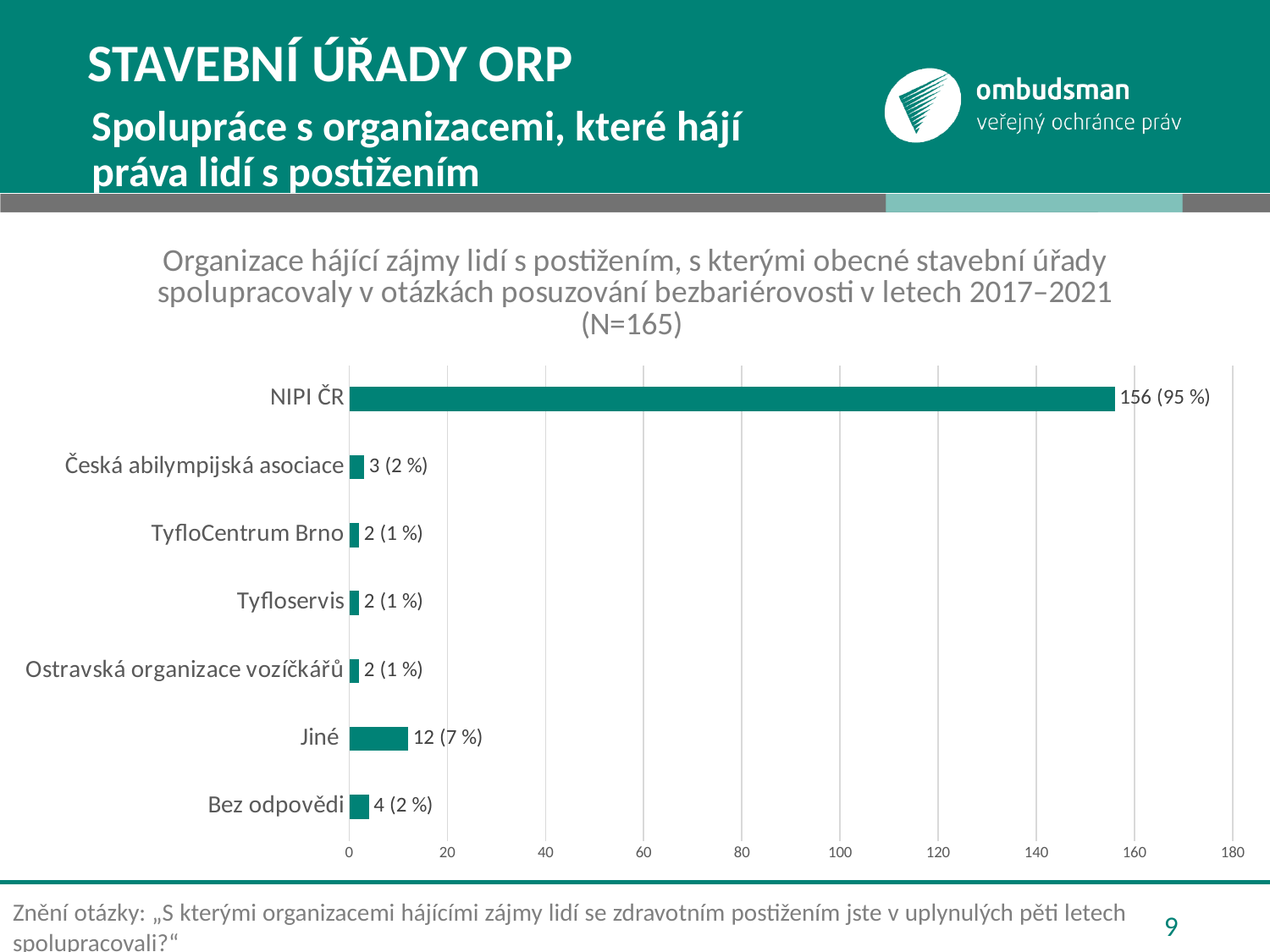
What is the N value stated in the chart title? 165 How many categories are shown on the chart? 7 What is the difference between the values for NIPI ČR and Jiné? 144 What is the value shown for Bez odpovědi? 4 (2 %) Which category has the highest value? NIPI ČR What is the value shown for Česká abilympijská asociace? 3 (2 %) What is the value shown for Jiné? 12 (7 %) What is the value shown for NIPI ČR? 156 (95 %) Is the value for NIPI ČR greater or less than 140? greater Which is larger, the value for Jiné or the value for Bez odpovědi? Jiné What kind of chart is shown on the slide? bar chart What is the value shown for TyfloCentrum Brno? 2 (1 %)